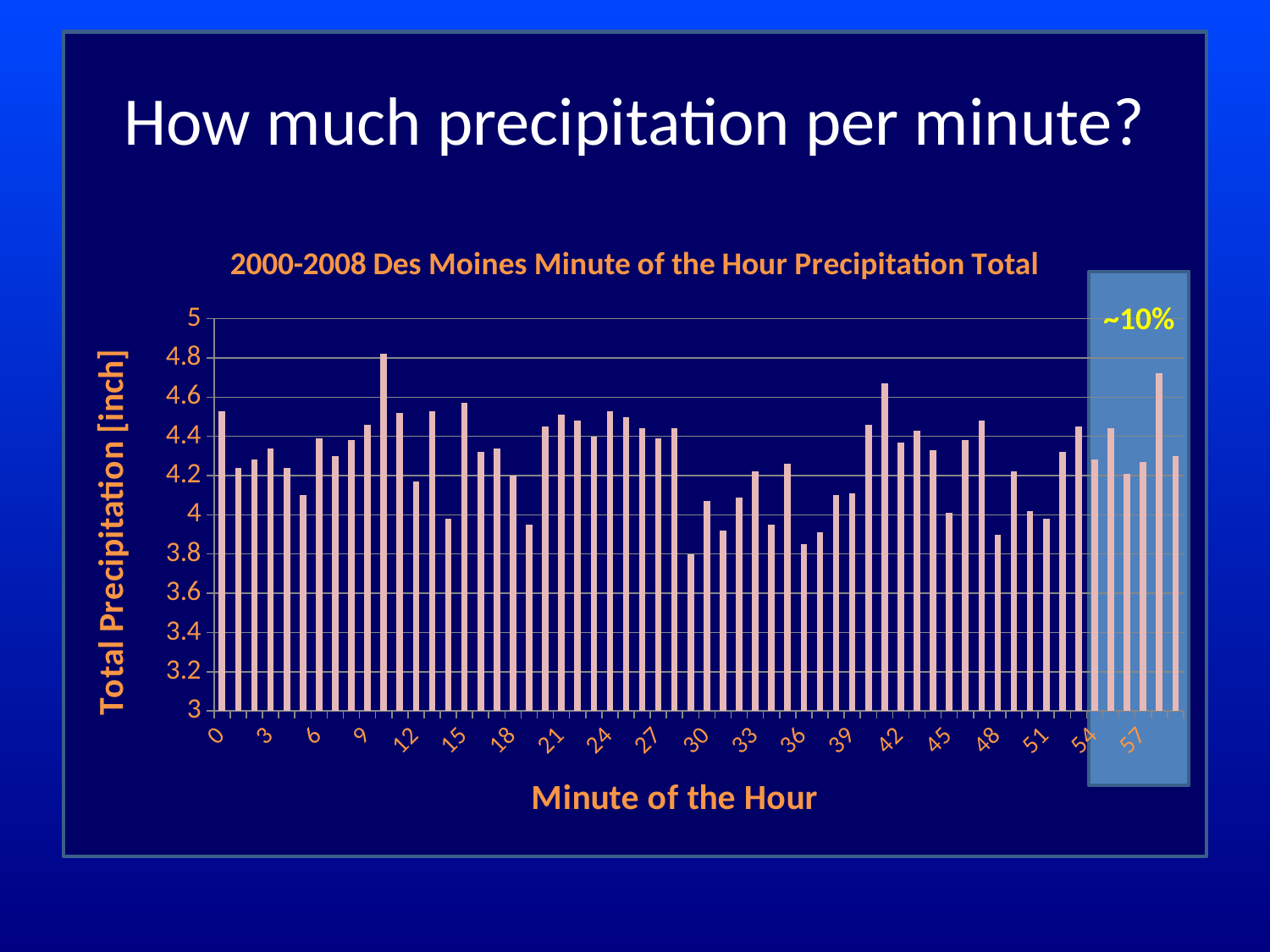
What kind of chart is shown on the slide? bar chart What is the title of the chart? 2000-2008 Des Moines Minute of the Hour Precipitation Total Which has the larger total precipitation, minute 10 or minute 30? minute 10 Which has the larger total precipitation, minute 0 or minute 1? minute 0 What is the lowest value shown on the vertical axis? 3 Which minute of the hour has the lowest total precipitation? 29 Is the value for minute 10 greater or less than 4.6? greater How many bars (minutes) are plotted in the chart? 60 What is the label of the vertical axis? Total Precipitation [inch] Which minute of the hour has the highest total precipitation? 10 Is the value for minute 0 greater or less than 4.4? greater